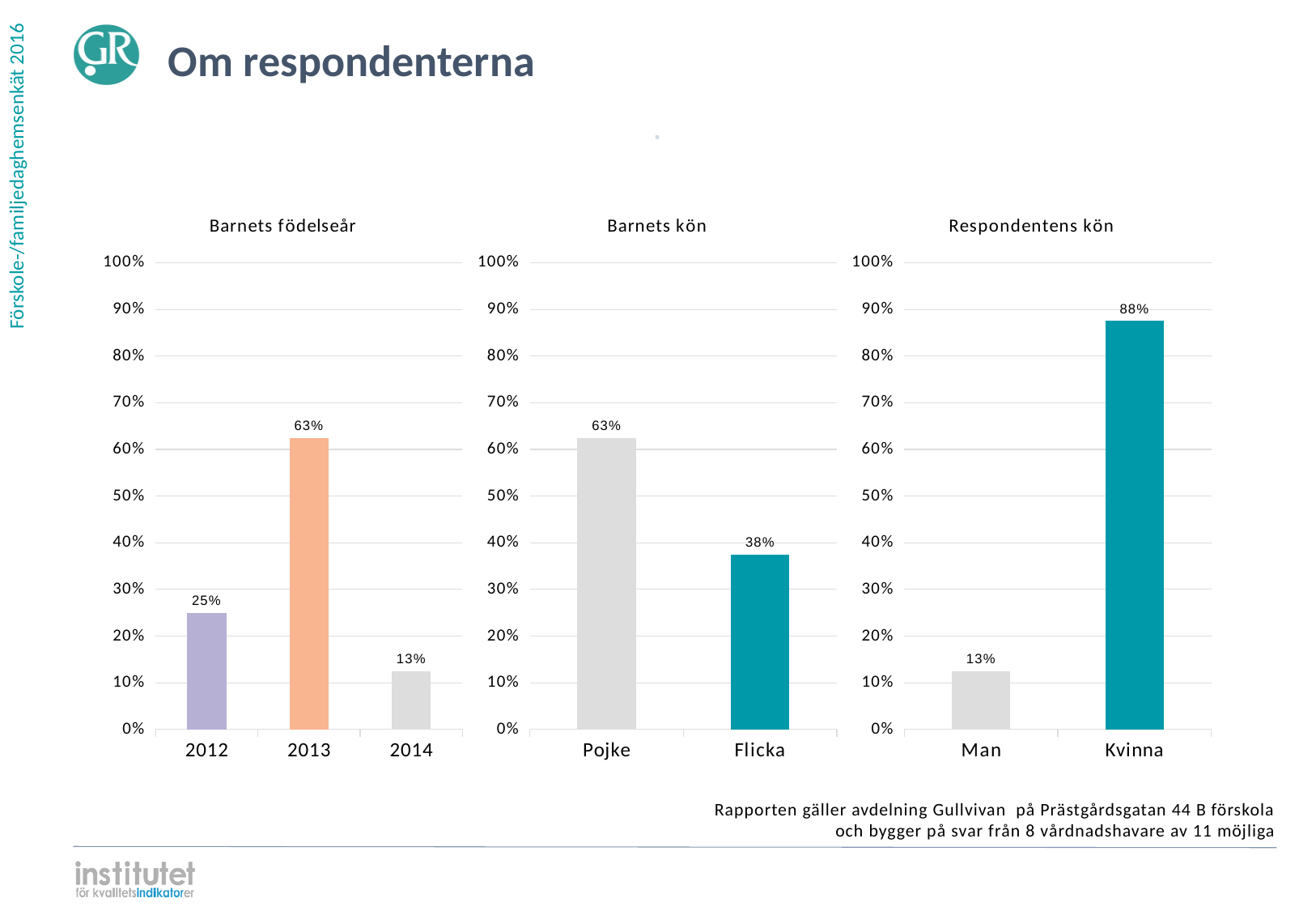
What kind of chart is the 'Respondentens kön' chart? Bar chart In the 'Barnets födelseår' chart, what is the difference between the values for 2013 and 2012? 38% In the 'Barnets födelseår' chart, which birth year has the lowest value? 2014 In the 'Respondentens kön' chart, what is the value for Man? 13% In the 'Barnets födelseår' chart, how many categories are shown on the x axis? 3 How many charts are shown on the slide? 3 In the 'Barnets kön' chart, which category is higher, Pojke or Flicka? Pojke In the 'Barnets kön' chart, what is the difference between Pojke and Flicka? 25% In the 'Respondentens kön' chart, what is the value for Kvinna? 88% In the 'Barnets kön' chart, what is the value for Flicka? 38% In the 'Barnets födelseår' chart, what is the value for 2013? 63% In the 'Respondentens kön' chart, which category has the highest value? Kvinna